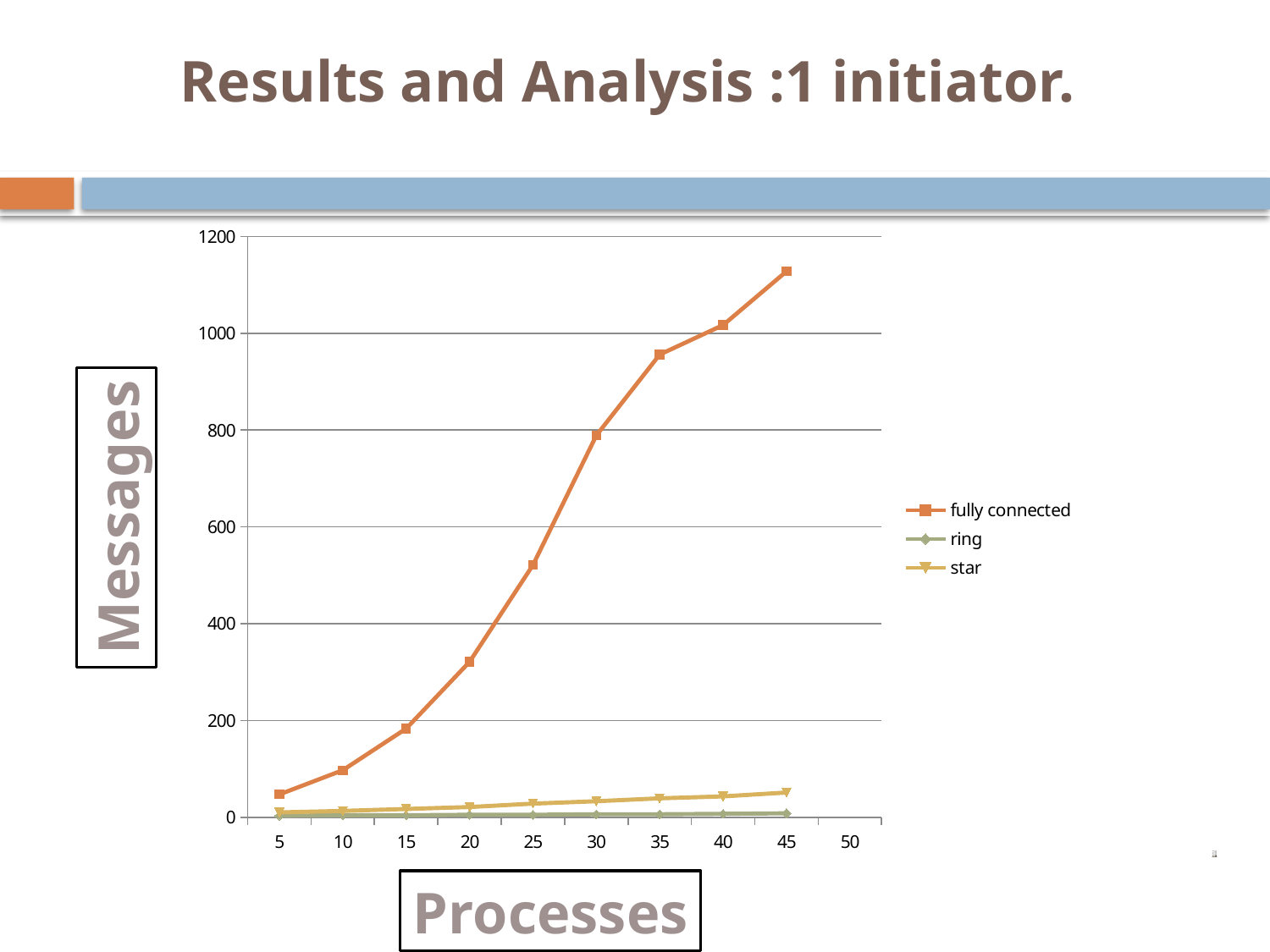
Which series has the highest number of messages at 45 processes? fully connected What is the label on the vertical axis of the chart? Messages How many data points are plotted for the fully connected series? 9 At 45 processes, which series has more messages, star or ring? star What kind of chart is shown on the slide? line chart Is the value for fully connected at 25 processes greater or less than 400? greater How many series does the legend list? 3 Is the value for fully connected at 45 processes greater or less than 1000? greater Which series has the lowest number of messages at 45 processes? ring Do the values for fully connected rise or fall as the number of processes increases? rise Is the value for star at 45 processes greater or less than 200? less